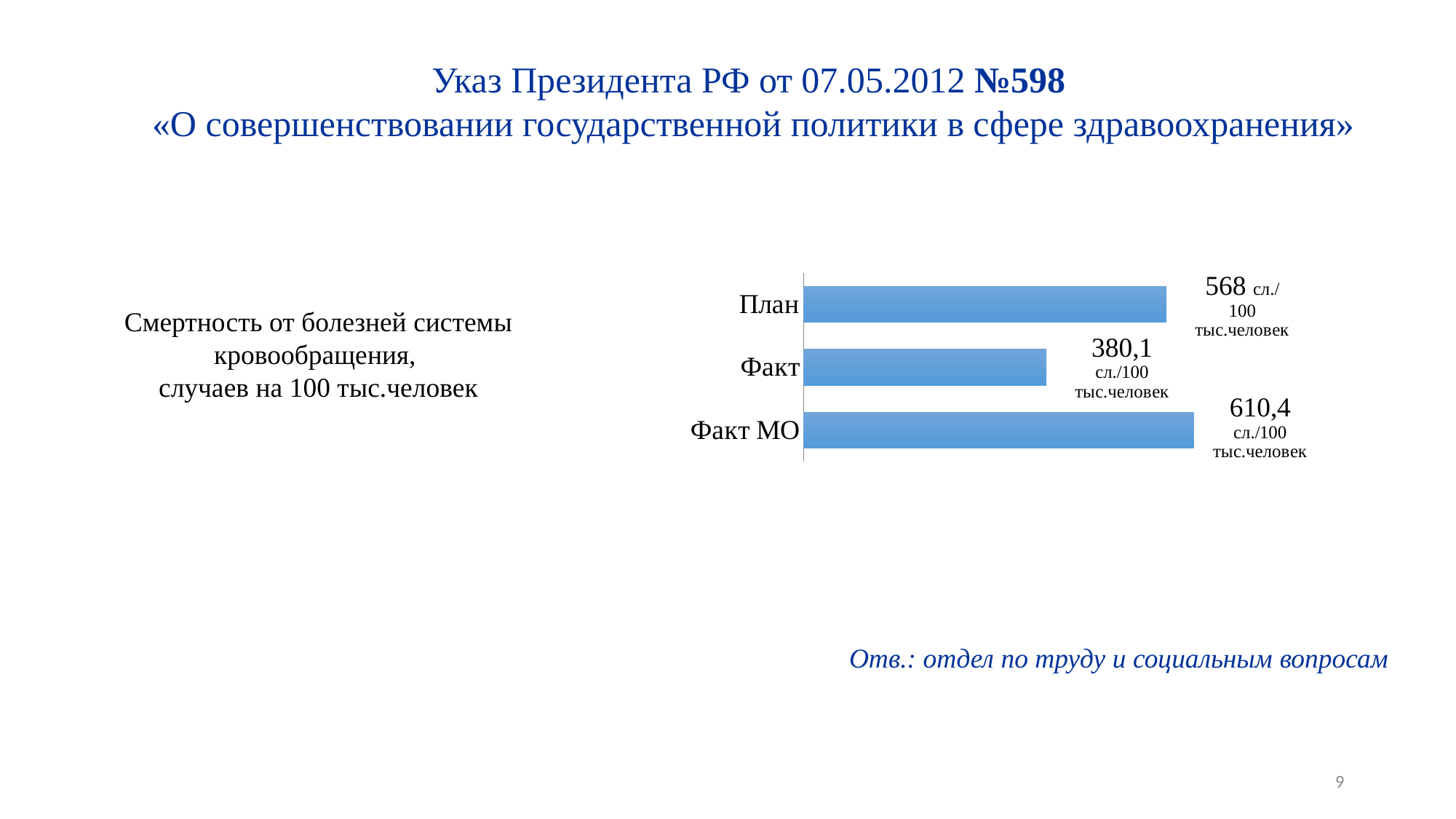
What is the difference between the values for Факт МО and План? 42,4 What unit is given for the values in the chart? сл./100 тыс.человек How many categories are shown in the chart? 3 What kind of chart is shown on the slide? Bar chart What is the difference between the values for План and Факт? 187,9 What is the value for Факт? 380,1 What is the value for Факт МО? 610,4 Which category has the highest value? Факт МО What indicator does the chart show, according to the text to its left? Смертность от болезней системы кровообращения, случаев на 100 тыс.человек Which is larger, the value for План or the value for Факт? План What is the value for План? 568 Which category has the lowest value? Факт